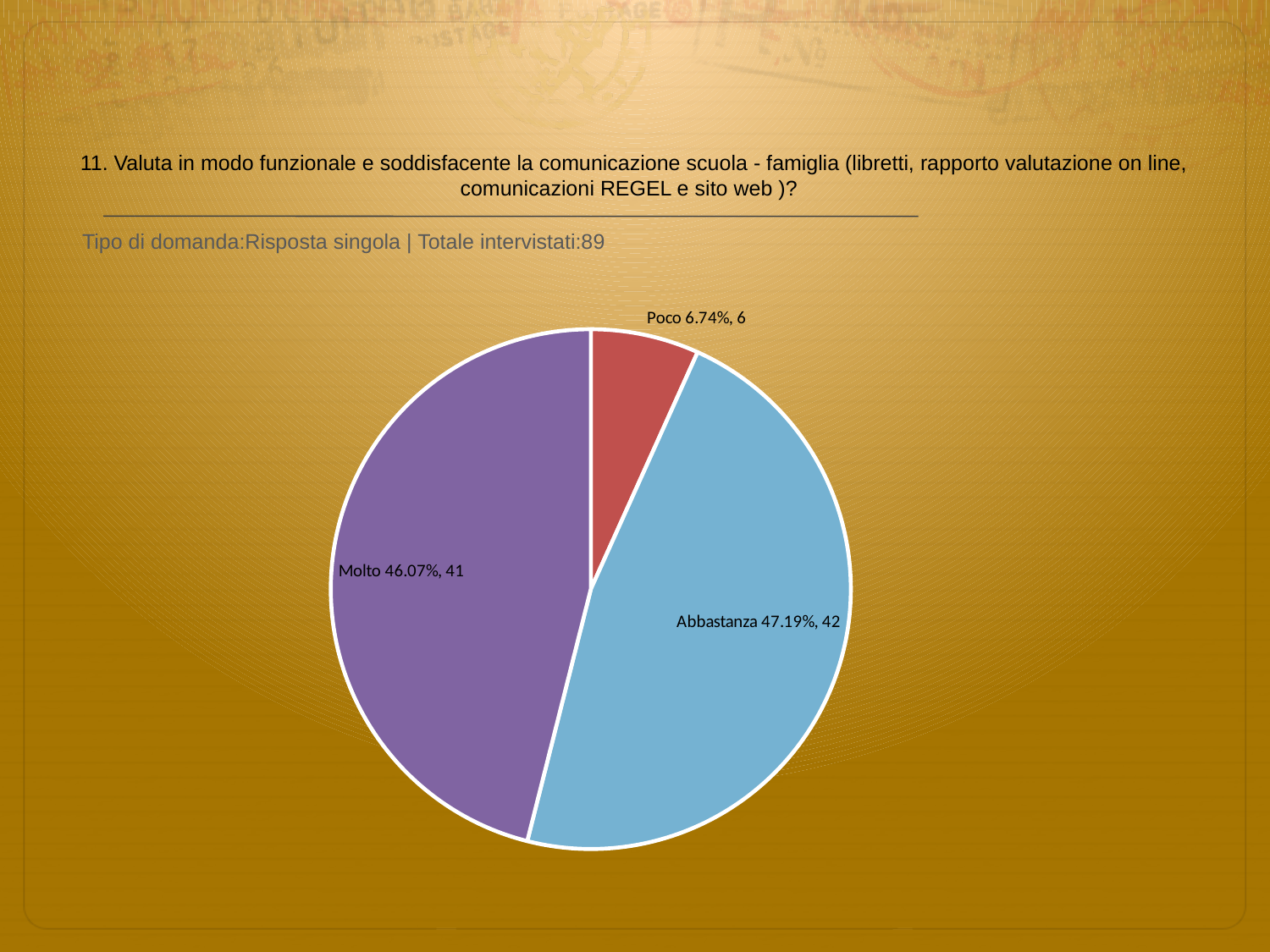
How many respondents answered "Poco"? 6 Which response category has the largest slice of the pie? Abbastanza How many respondents answered "Abbastanza"? 42 What is the difference in respondent count between "Abbastanza" and "Molto"? 1 What percentage of respondents answered "Molto"? 46.07% How many more respondents answered "Abbastanza" than "Poco"? 36 What colour is the "Molto" slice of the pie? Purple What is the total number of respondents across all three slices? 89 What type of chart is shown on the slide? Pie chart How many response categories are shown in the pie chart? 3 Which response category has the smallest slice of the pie? Poco What percentage of the pie does the "Poco" slice represent? 6.74%